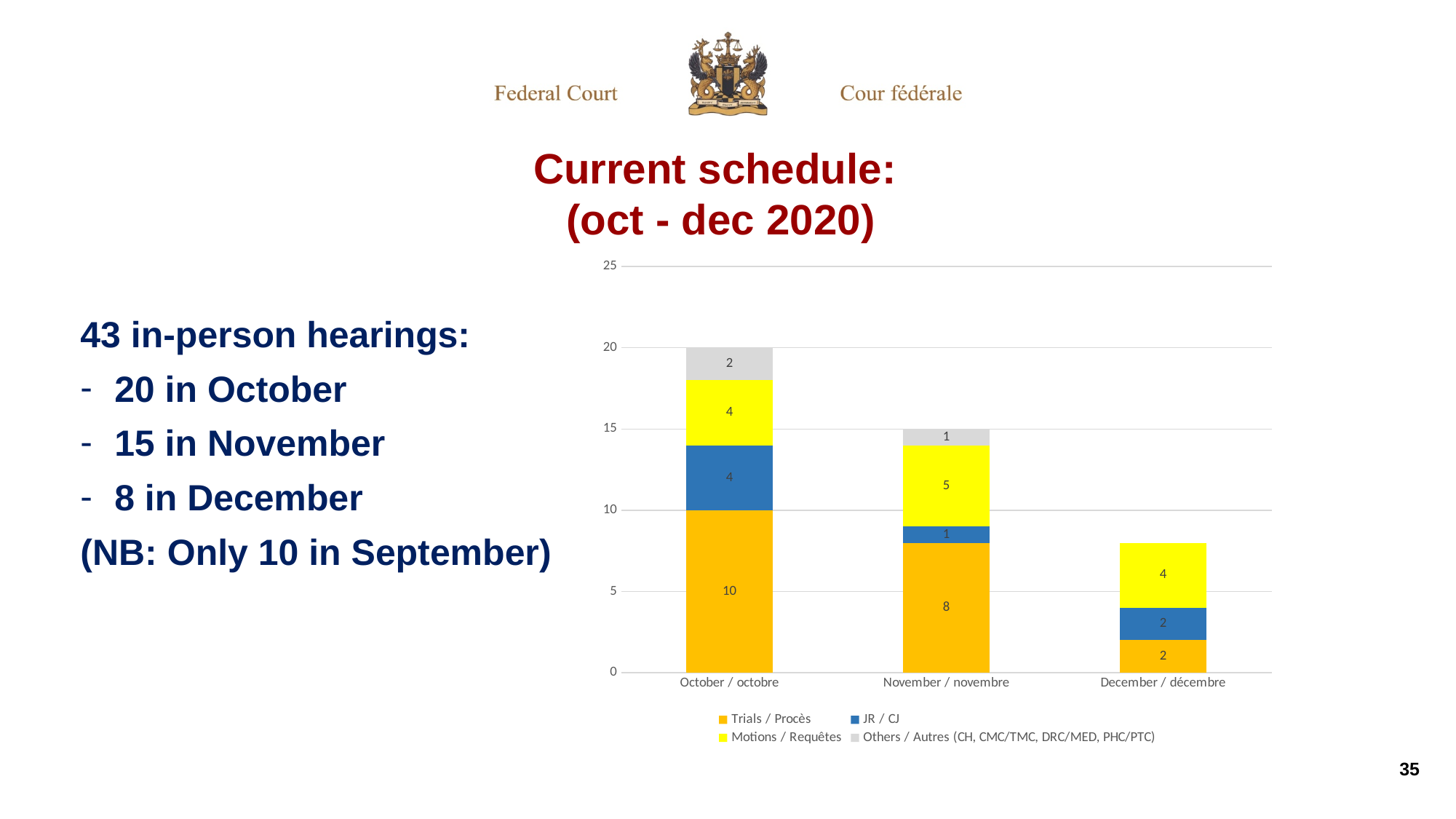
What is the value for Others / Autres in October / octobre? 2 Which month has the highest total stacked bar? October / octobre What type of chart is shown on the slide? Stacked bar chart How many months are shown on the x axis of the chart? 3 What is the value for Trials / Procès in October / octobre? 10 What is the total of the stacked bar for November / novembre? 15 What is the value for Motions / Requêtes in November / novembre? 5 How many series does the chart legend list? 4 What is the difference between the Trials / Procès values for October / octobre and November / novembre? 2 What is the total of the stacked bar for December / décembre? 8 Do the total bar heights rise or fall from October to December? Fall What is the value for JR / CJ in December / décembre? 2